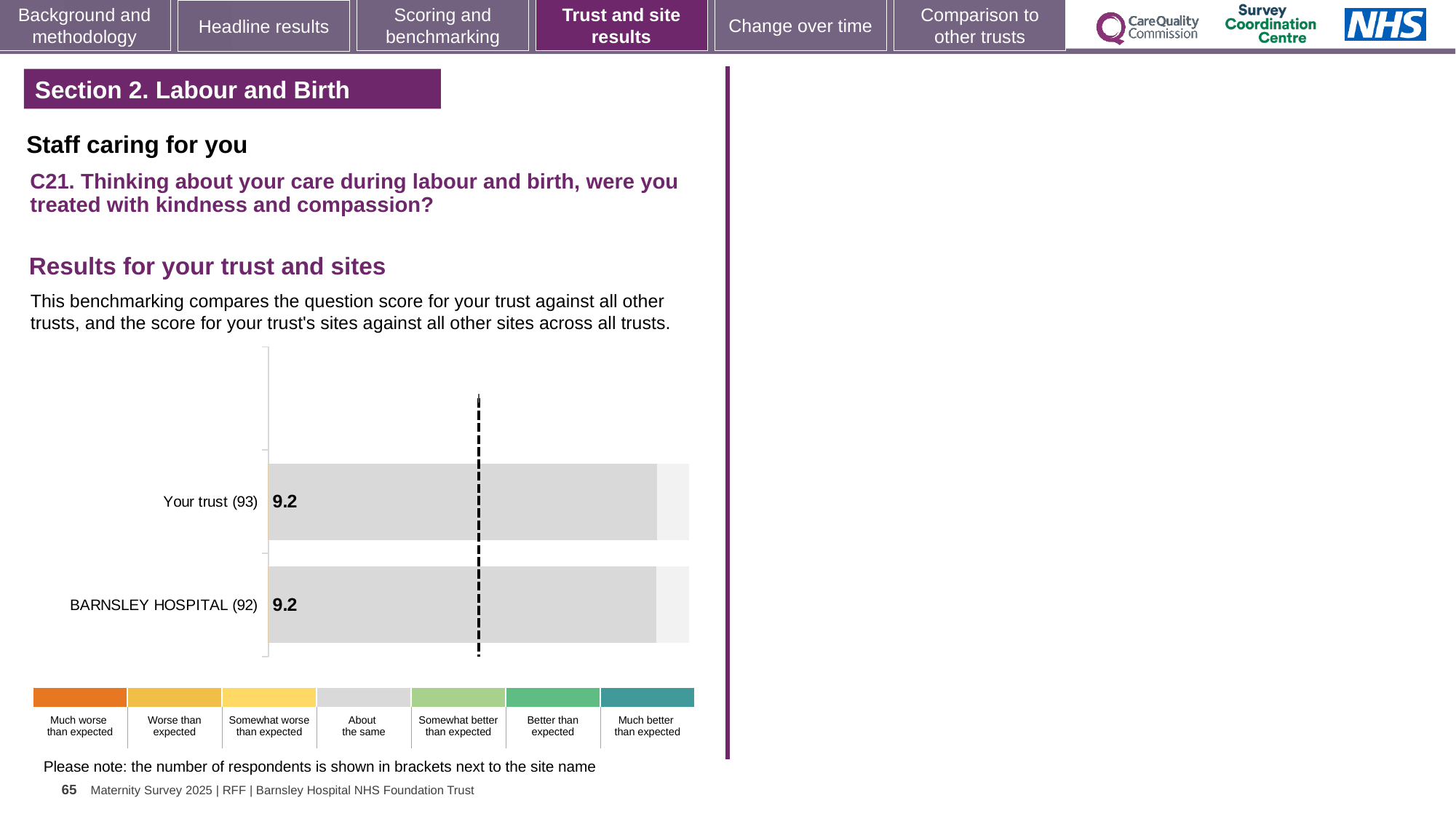
Which survey question does the chart relate to? C21. Thinking about your care during labour and birth, were you treated with kindness and compassion? What is the score for Your trust (93)? 9.2 What is the difference between the score for Your trust and the score for BARNSLEY HOSPITAL? 0 Which benchmark category does the grey colour of the bars correspond to in the key? About the same What is the score for BARNSLEY HOSPITAL (92)? 9.2 What kind of chart is shown on the slide? Bar chart How many respondents are shown in brackets for Your trust? 93 How many respondents are shown in brackets for BARNSLEY HOSPITAL? 92 How many bars are plotted in the chart? 2 How many benchmark categories does the colour key below the chart list? 7